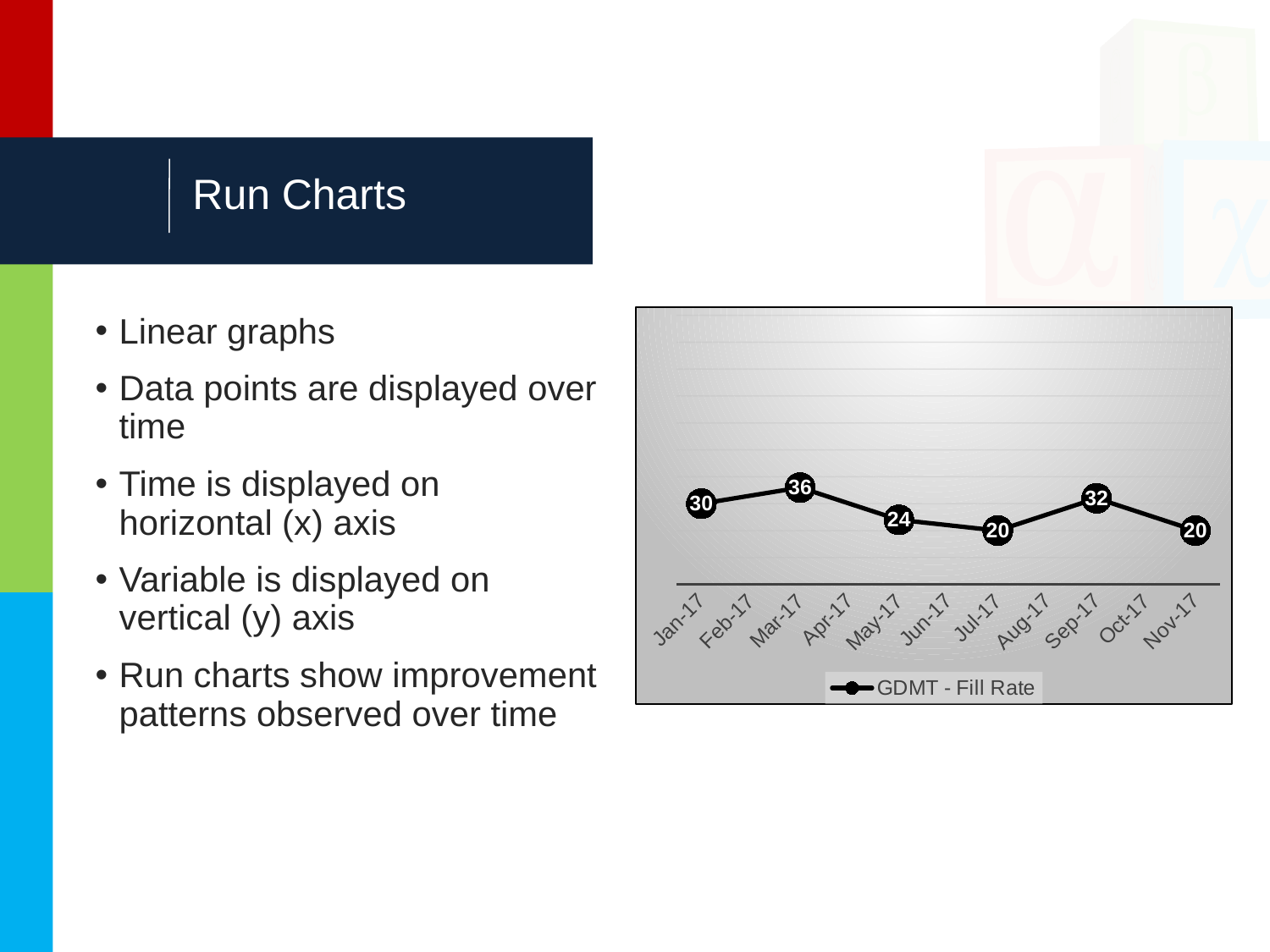
Is the value at Sep-17 larger or smaller than the value at Nov-17? larger What is the value of the second data point on the line (at Mar-17)? 36 What is the lowest value plotted on the line? 20 How many data points are plotted on the line? 6 How many series does the legend list? 1 What is the value of the data point at May-17? 24 What is the value of the data point at Sep-17? 32 What is the value of the first data point on the line (at Jan-17)? 30 What series does the chart's legend list? GDMT - Fill Rate What is the highest value plotted on the line? 36 What kind of chart is shown on the slide? line chart What is the difference between the highest value (36) and the first value (30)? 6